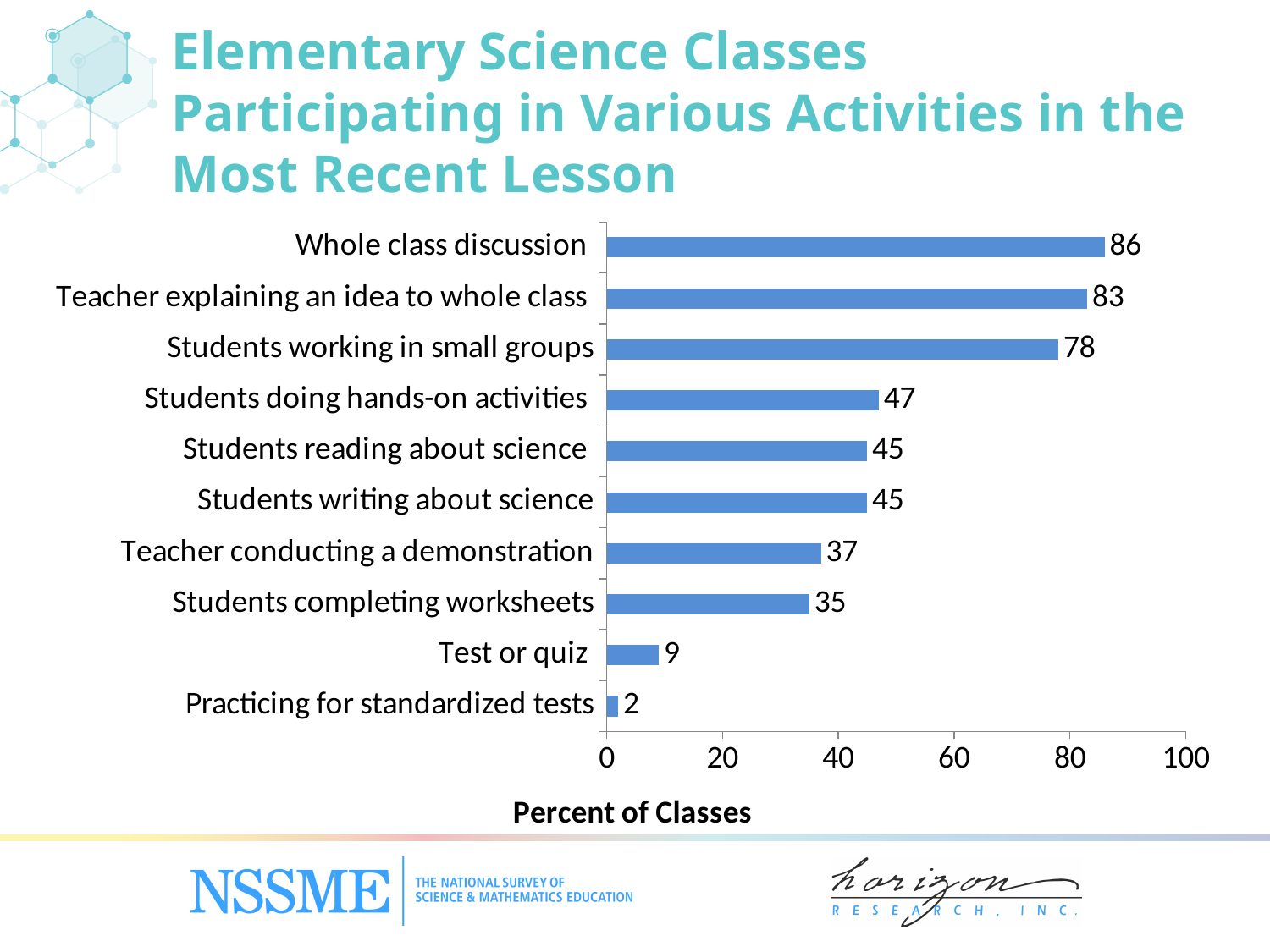
Is the value for Students working in small groups greater or less than 60? greater What is the value for Students completing worksheets? 35 What is the label of the horizontal axis? Percent of Classes How many activities are shown in the chart? 10 Which activity has the lowest percent of classes? Practicing for standardized tests What kind of chart is shown on the slide? bar chart What is the difference between the values for Teacher conducting a demonstration and Students completing worksheets? 2 What is the value for Test or quiz? 9 Which is larger, the value for Students doing hands-on activities or the value for Teacher conducting a demonstration? Students doing hands-on activities What percent of classes had whole class discussion in the most recent lesson? 86 What is the difference between the values for Whole class discussion and Students working in small groups? 8 Which activity has the highest percent of classes? Whole class discussion